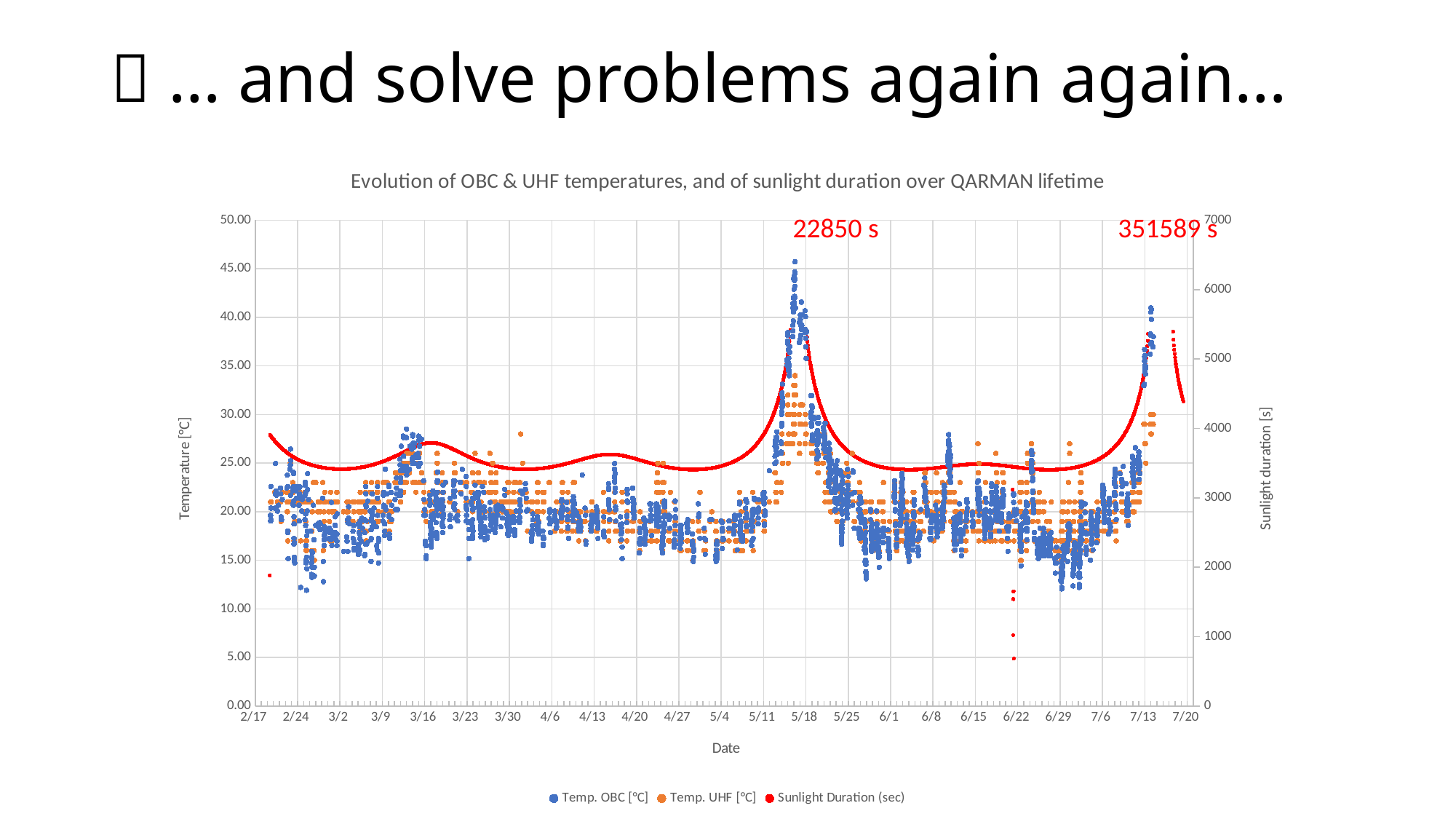
What kind of chart is shown on the slide? scatter chart What annotated value is printed in red near the sunlight duration peak around 5/18? 22850 s Does the Sunlight Duration curve rise or fall between 5/18 and 5/25? fall How many series does the legend list? 3 What is the title of the chart? Evolution of OBC & UHF temperatures, and of sunlight duration over QARMAN lifetime Is the lowest Temp. OBC value around 6/29 greater or less than 15.00 °C? less Is the Sunlight Duration value around 3/2 greater or less than 4000 s? less Which Temp. OBC peak is higher: the one around 5/18 or the one around 7/13? the one around 5/18 Is the peak Temp. OBC value around 5/18 greater or less than 40.00 °C? greater Does the Sunlight Duration curve rise or fall between 6/29 and 7/13? rise How many date tick labels are shown on the x axis? 23